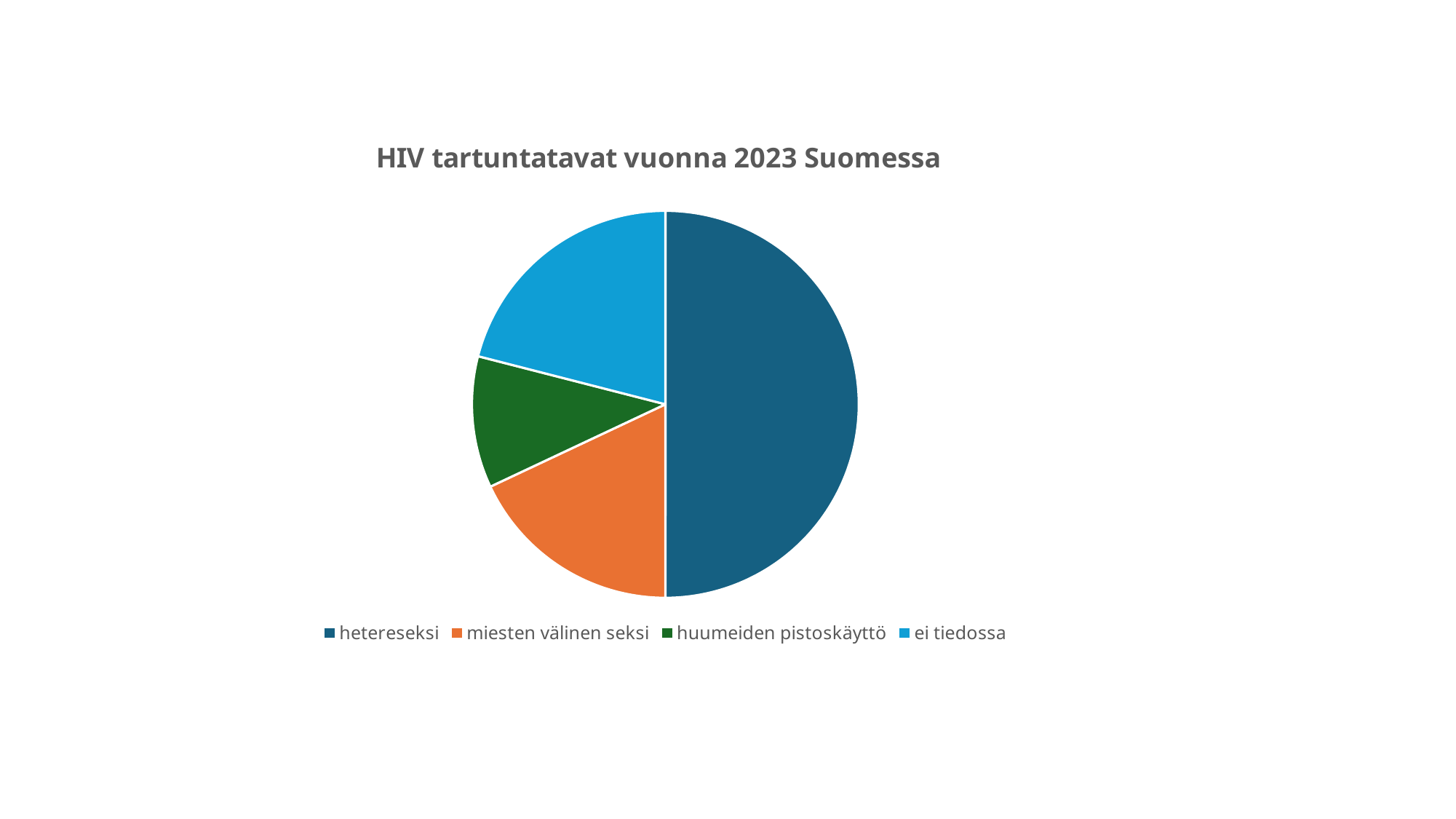
What is the title of the chart? HIV tartuntatavat vuonna 2023 Suomessa Which slice is larger, heteroseksi or miesten välinen seksi? hetereseksi How many slices does the pie chart have? 4 Which category has the smallest slice of the pie? huumeiden pistoskäyttö Which slice is larger, ei tiedossa or huumeiden pistoskäyttö? ei tiedossa Which slice is larger, miesten välinen seksi or huumeiden pistoskäyttö? miesten välinen seksi Which category is shown in orange in the pie chart? miesten välinen seksi Which category has the largest slice of the pie? hetereseksi How many entries does the legend list? 4 What kind of chart is shown on the slide? pie chart